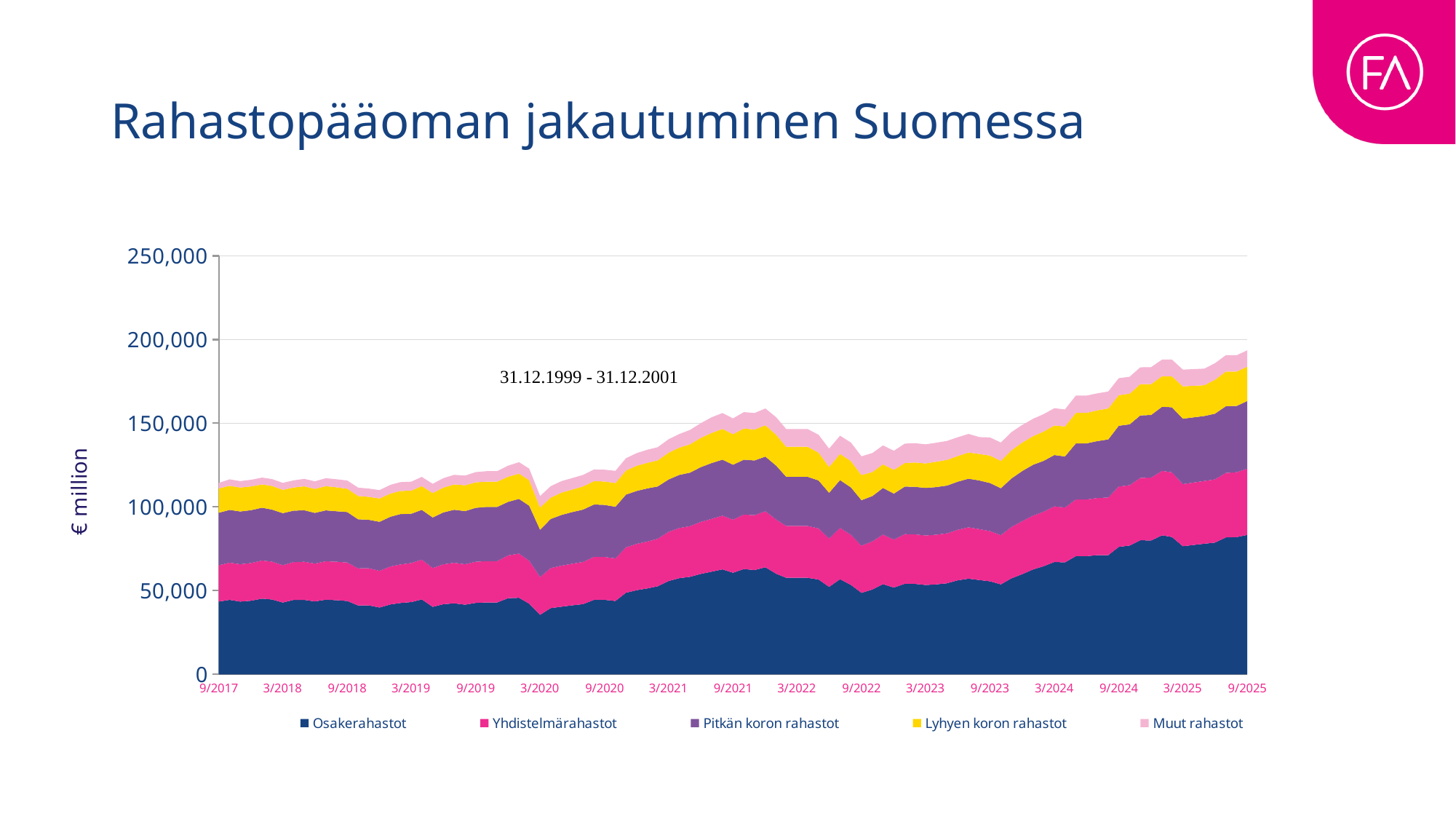
Does the total fund capital rise or fall overall from 9/2017 to 9/2025? Rise How many date labels are shown along the x axis? 17 Is the total stacked value at 9/2025 greater or less than 150,000? greater Which series has the largest value at 9/2025? Osakerahastot What kind of chart is shown on the slide? Stacked area chart Is the total stacked value larger at 9/2025 or at 9/2017? 9/2025 Is the value for Osakerahastot at 9/2025 greater or less than 50,000? greater What unit is shown on the vertical axis label? € million What is the title of the slide's chart? Rahastopääoman jakautuminen Suomessa Is the total stacked value at 9/2022 greater or less than 150,000? less How many series does the legend list? 5